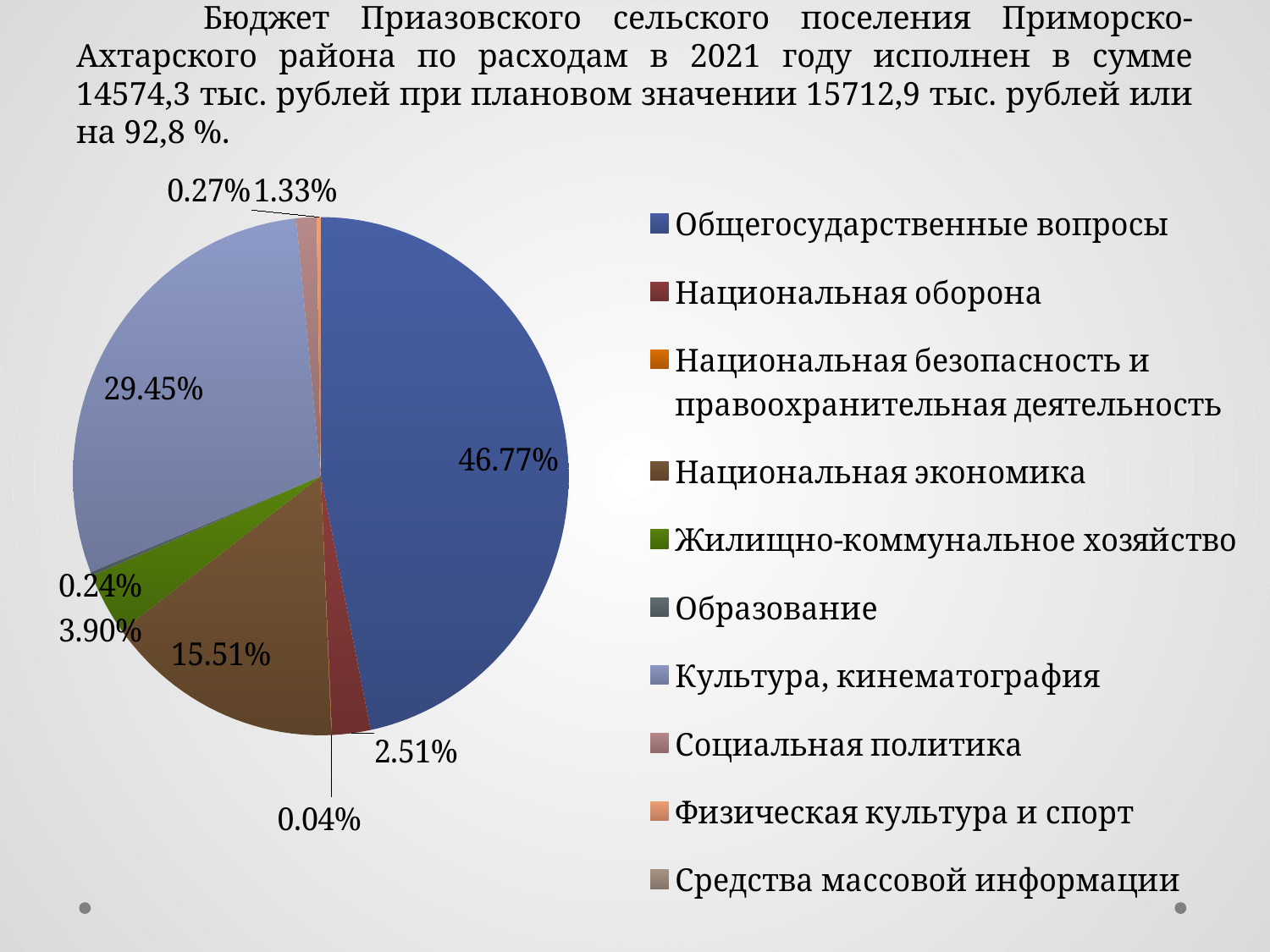
How many categories does the legend list? 10 What share of the pie does Образование have? 0.24% What share of the pie does Национальная оборона have? 2.51% What share of the pie does Культура, кинематография have? 29.45% Which category has the largest slice of the pie? Общегосударственные вопросы What colour is the slice for Общегосударственные вопросы? blue Which is larger: the share of Национальная экономика or the share of Жилищно-коммунальное хозяйство? Национальная экономика What share of the pie does Национальная экономика have? 15.51% What kind of chart is shown on the slide? pie chart What share of the pie does Общегосударственные вопросы have? 46.77% What is the difference between the shares of Общегосударственные вопросы and Культура, кинематография? 17.32% What share of the pie does Жилищно-коммунальное хозяйство have? 3.90%